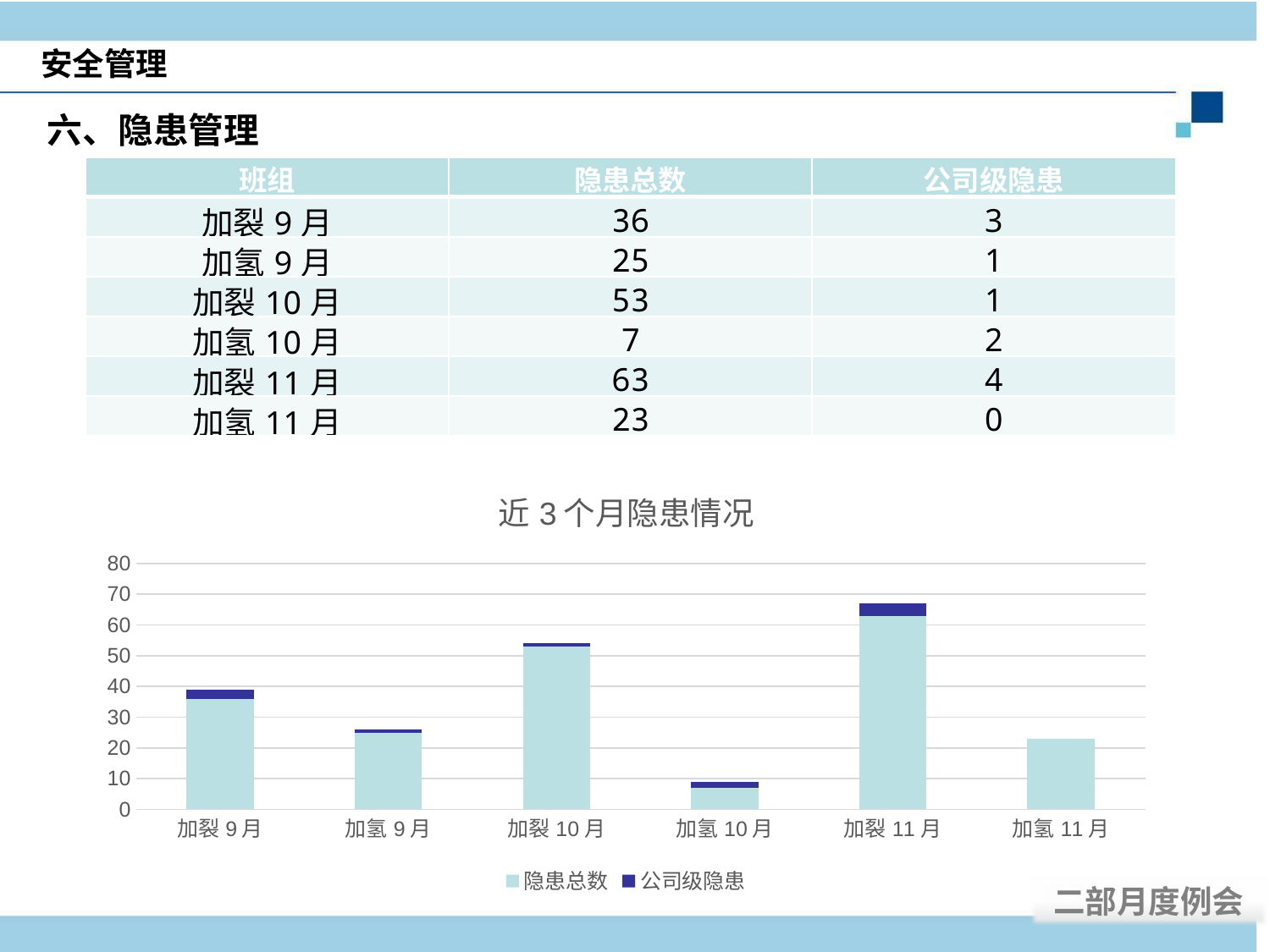
Is the 隐患总数 bar for 加氢 11 月 greater or less than 30? less What is the title of the chart? 近 3 个月隐患情况 What is the 公司级隐患 value for 加裂 11 月? 4 Is the 隐患总数 bar for 加裂 11 月 greater or less than 60? greater Which category has the lowest 隐患总数 in the chart? 加氢 10 月 How many series does the chart legend list? 2 Which category has the highest 隐患总数 in the chart? 加裂 11 月 What is the difference in 隐患总数 between 加裂 10 月 and 加裂 9 月? 17 How many categories are shown on the x axis of the chart? 6 What kind of chart is shown on the slide? bar chart What is the total height of the stacked bar for 加裂 11 月 (隐患总数 plus 公司级隐患)? 67 What is the 隐患总数 value for 加裂 10 月? 53